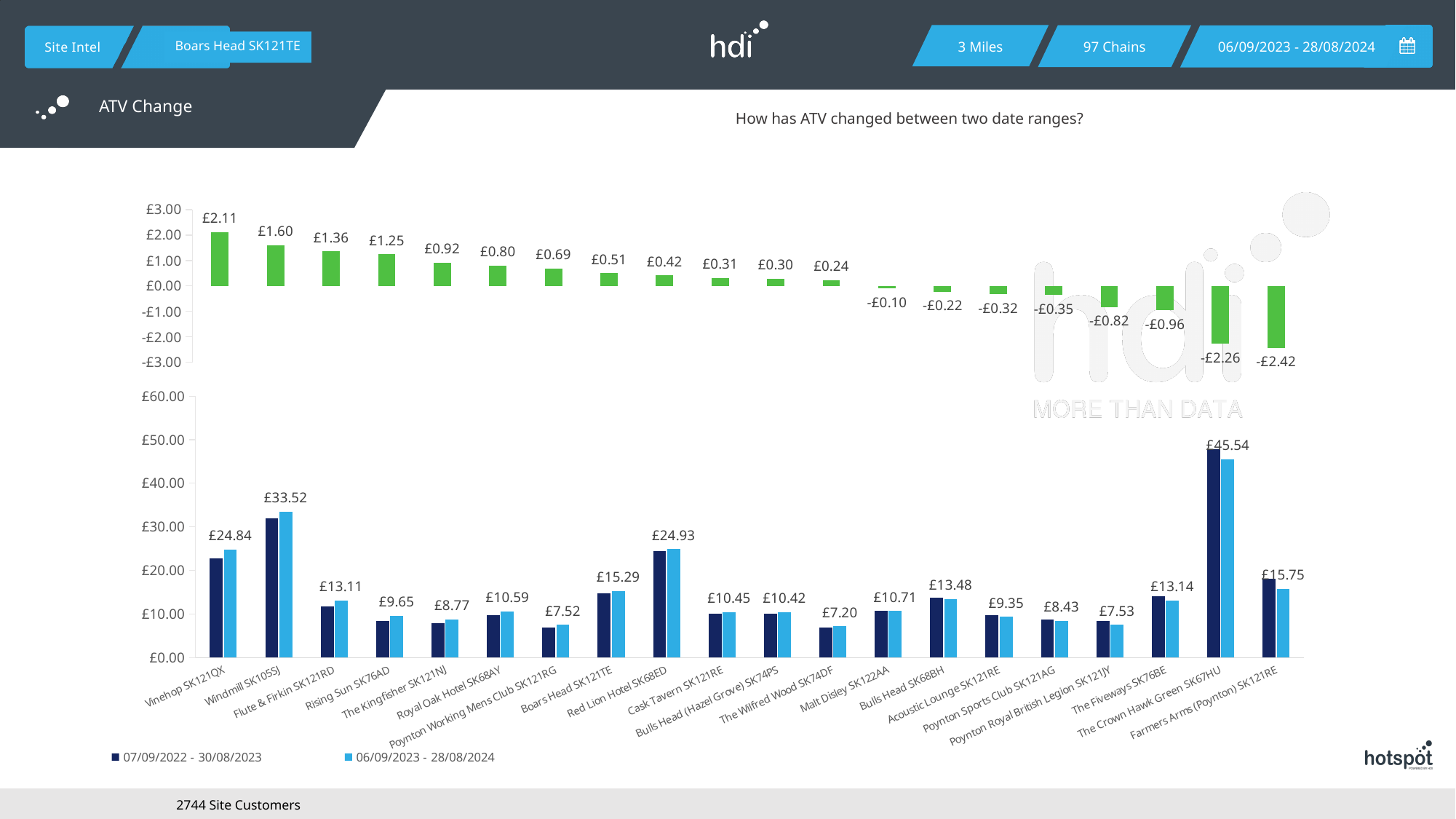
In the lower chart, what is the value for Windmill SK105SJ in the 06/09/2023 - 28/08/2024 period? £33.52 In the lower chart, is the 07/09/2022 - 30/08/2023 value for The Crown Hawk Green SK67HU greater or less than £40.00? greater In the upper ATV change chart, do the values rise or fall from left to right? fall How many series does the legend of the lower chart list? 2 What kind of chart is the lower chart showing ATV by venue? bar chart In the lower chart, what is the difference between the labelled values for Windmill SK105SJ and Vinehop SK121QX? £8.68 In the lower chart, which venue has the lowest labelled value for the 06/09/2023 - 28/08/2024 period? The Wilfred Wood SK74DF In the lower chart, which venue has the highest value for the 06/09/2023 - 28/08/2024 period? The Crown Hawk Green SK67HU In the lower chart, which is larger for the 06/09/2023 - 28/08/2024 period: Windmill SK105SJ or Red Lion Hotel SK68ED? Windmill SK105SJ In the upper ATV change chart, what is the largest positive change shown? £2.11 In the upper ATV change chart, what is the lowest value shown? -£2.42 How many venues are shown on the x axis of the lower chart? 20